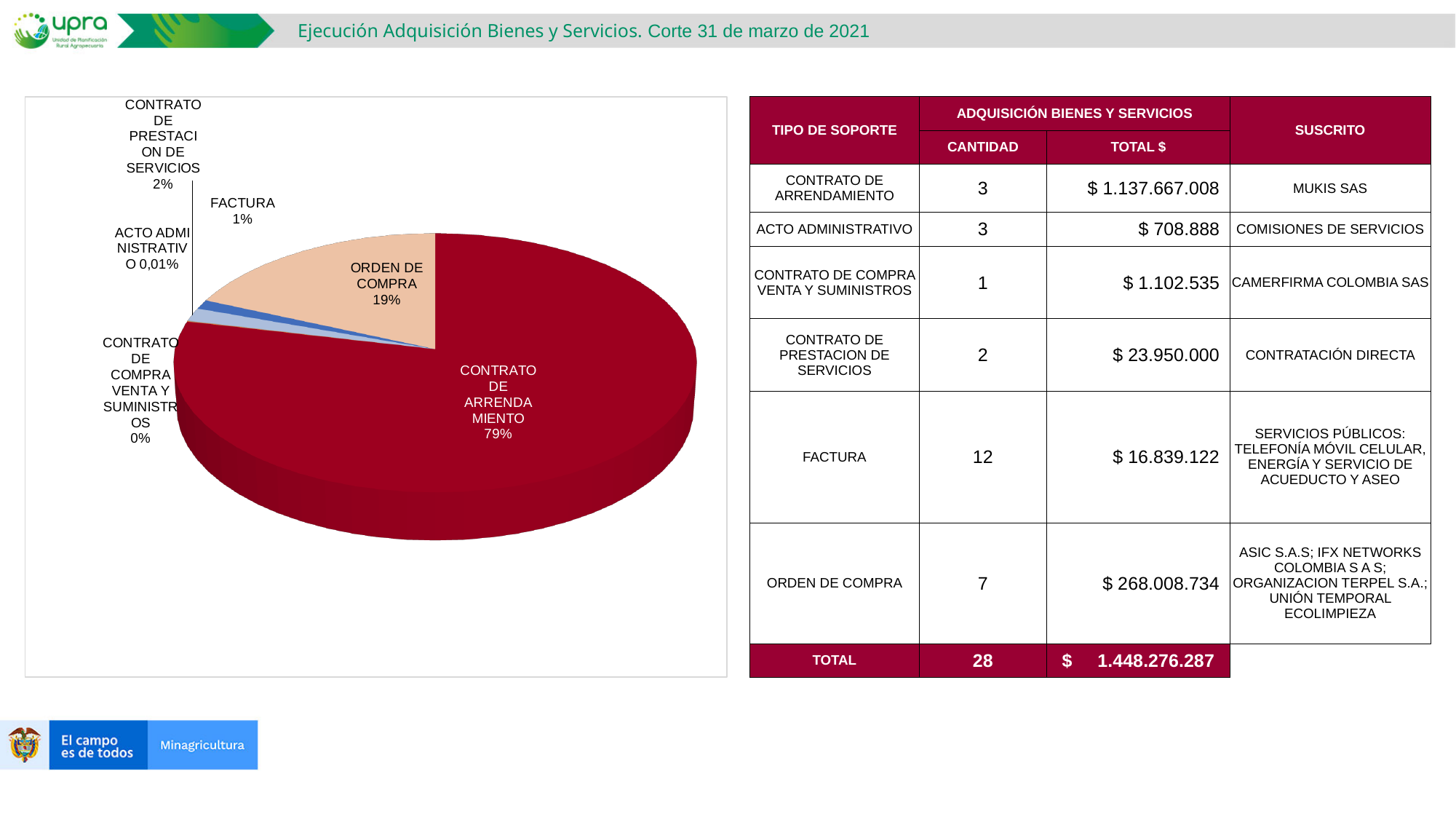
Which has a larger share in the pie chart, FACTURA or CONTRATO DE PRESTACION DE SERVICIOS? CONTRATO DE PRESTACION DE SERVICIOS What share of the pie does ORDEN DE COMPRA represent? 19% What percentage is shown for CONTRATO DE COMPRA VENTA Y SUMINISTROS in the pie chart? 0% What percentage is shown for CONTRATO DE PRESTACION DE SERVICIOS in the pie chart? 2% How many slices does the pie chart have? 6 What is the difference in percentage points between CONTRATO DE ARRENDAMIENTO and ORDEN DE COMPRA in the pie chart? 60 What share of the pie does CONTRATO DE ARRENDAMIENTO represent? 79% What percentage is shown for ACTO ADMINISTRATIVO in the pie chart? 0,01% What percentage is shown for FACTURA in the pie chart? 1% What kind of chart is shown on the slide? pie chart Which category has the smallest share in the pie chart? ACTO ADMINISTRATIVO Which category has the largest slice of the pie chart? CONTRATO DE ARRENDAMIENTO